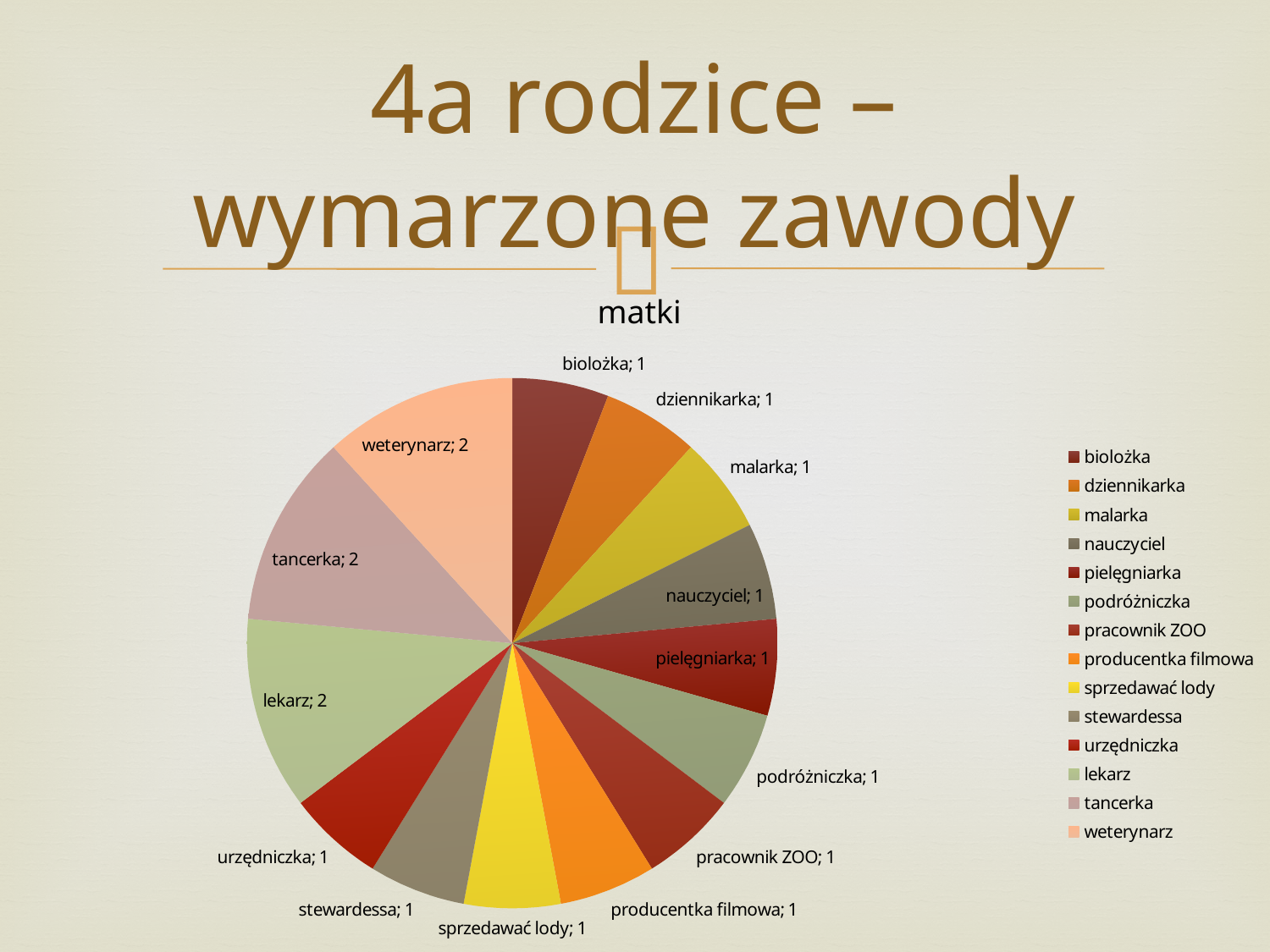
How many entries does the legend list? 14 What is the title of the chart? matki What is the total of all the values in the pie chart? 17 Which is larger, the value for tancerka or the value for stewardessa? tancerka What is the value for pracownik ZOO? 1 What is the value for biolożka? 1 What is the value for lekarz? 2 What is the value for weterynarz? 2 What type of chart is shown on the slide? pie chart How many categories (slices) does the pie chart have? 14 Which categories have the highest value in the chart? lekarz, tancerka, weterynarz What is the difference between the value for weterynarz and the value for malarka? 1